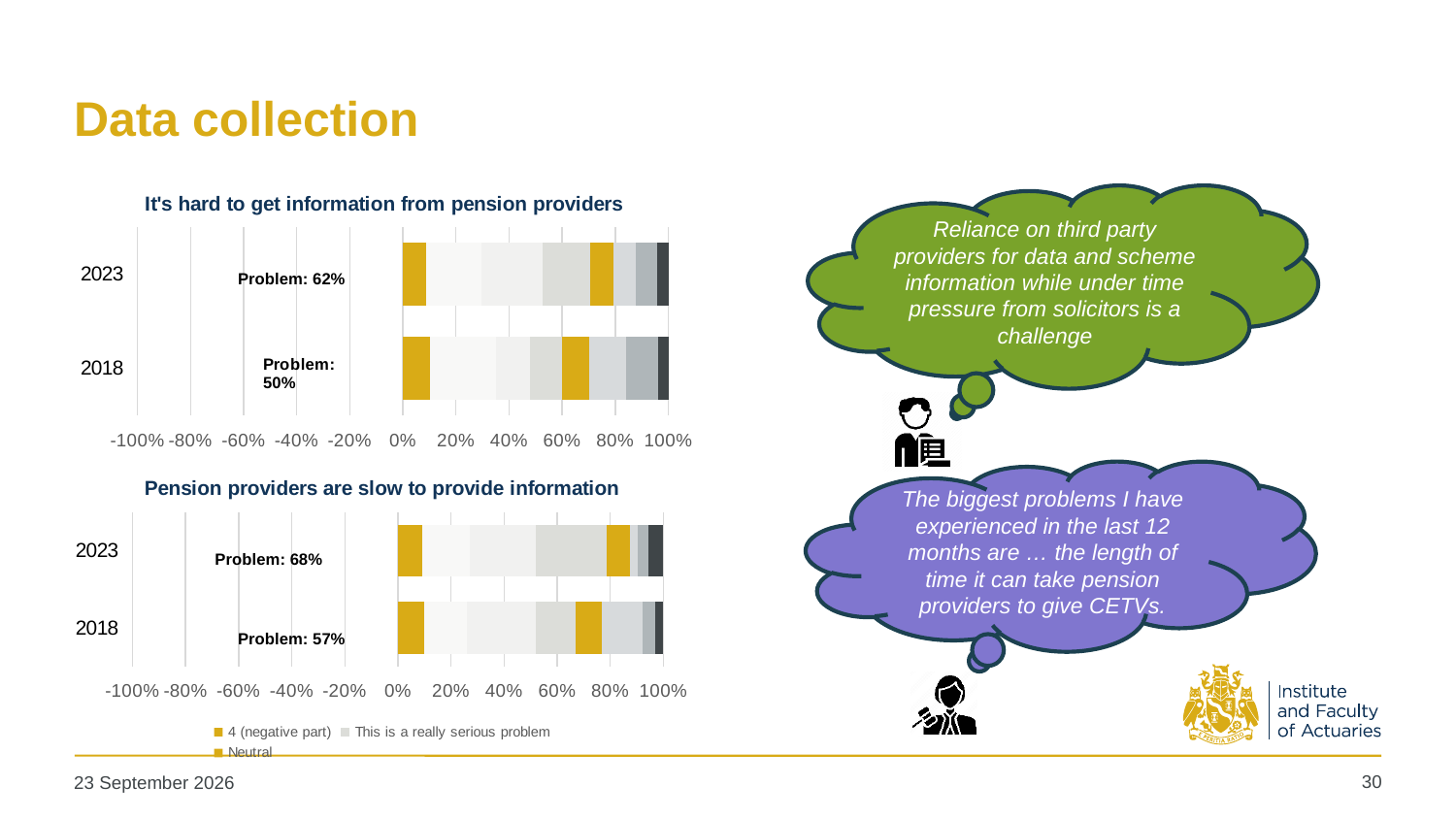
In the chart titled "It's hard to get information from pension providers", which year has the higher Problem percentage, 2023 or 2018? 2023 What type of chart is used for "It's hard to get information from pension providers"? Stacked bar chart In the chart titled "It's hard to get information from pension providers", what is the Problem percentage shown for 2018? 50% How many years (categories) are plotted in the chart titled "Pension providers are slow to provide information"? 2 In the chart titled "Pension providers are slow to provide information", what is the difference between the 2023 and 2018 Problem percentages? 11 percentage points In the chart titled "Pension providers are slow to provide information", which year has the lower Problem percentage? 2018 What is the title of the upper chart on the slide? It's hard to get information from pension providers In the chart titled "Pension providers are slow to provide information", what is the Problem percentage shown for 2018? 57% In the chart titled "It's hard to get information from pension providers", what is the Problem percentage shown for 2023? 62% In the chart titled "It's hard to get information from pension providers", did the Problem percentage rise or fall from 2018 to 2023? Rise In the chart titled "Pension providers are slow to provide information", what is the Problem percentage shown for 2023? 68% In the chart titled "It's hard to get information from pension providers", by how many percentage points did the Problem share change from 2018 to 2023? 12 percentage points